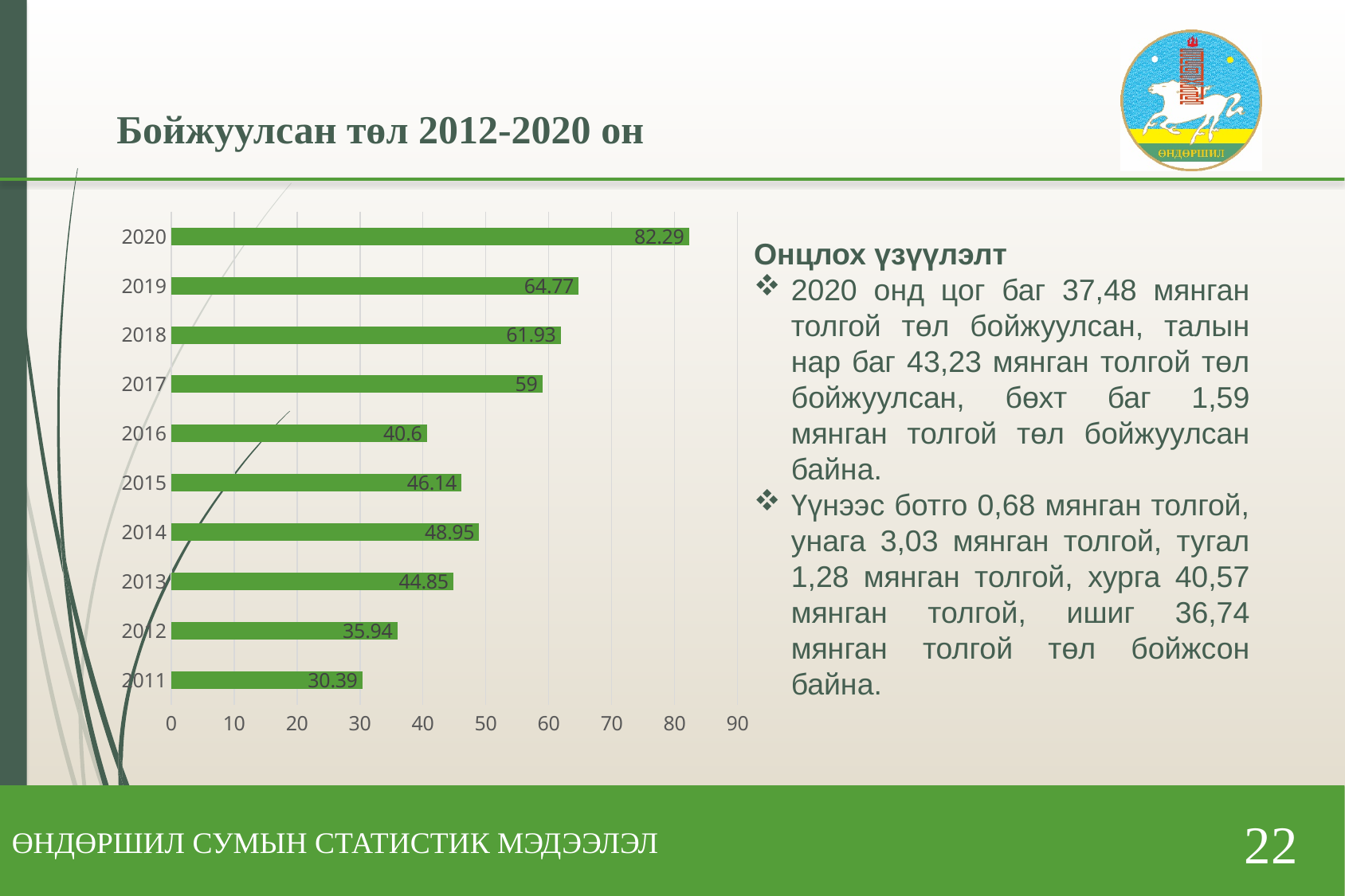
Which year has the lowest value? 2011 What is the value for 2017? 59 Is the value for 2018 greater or less than 60? greater Which is larger, the value for 2015 or the value for 2016? 2015 What is the difference between the values for 2014 and 2013? 4.1 Which year has the highest value? 2020 What is the difference between the values for 2020 and 2019? 17.52 What is the value for 2016? 40.6 What is the value for 2011? 30.39 How many years are shown in the chart? 10 What is the value for 2020? 82.29 What kind of chart is shown on the slide? bar chart